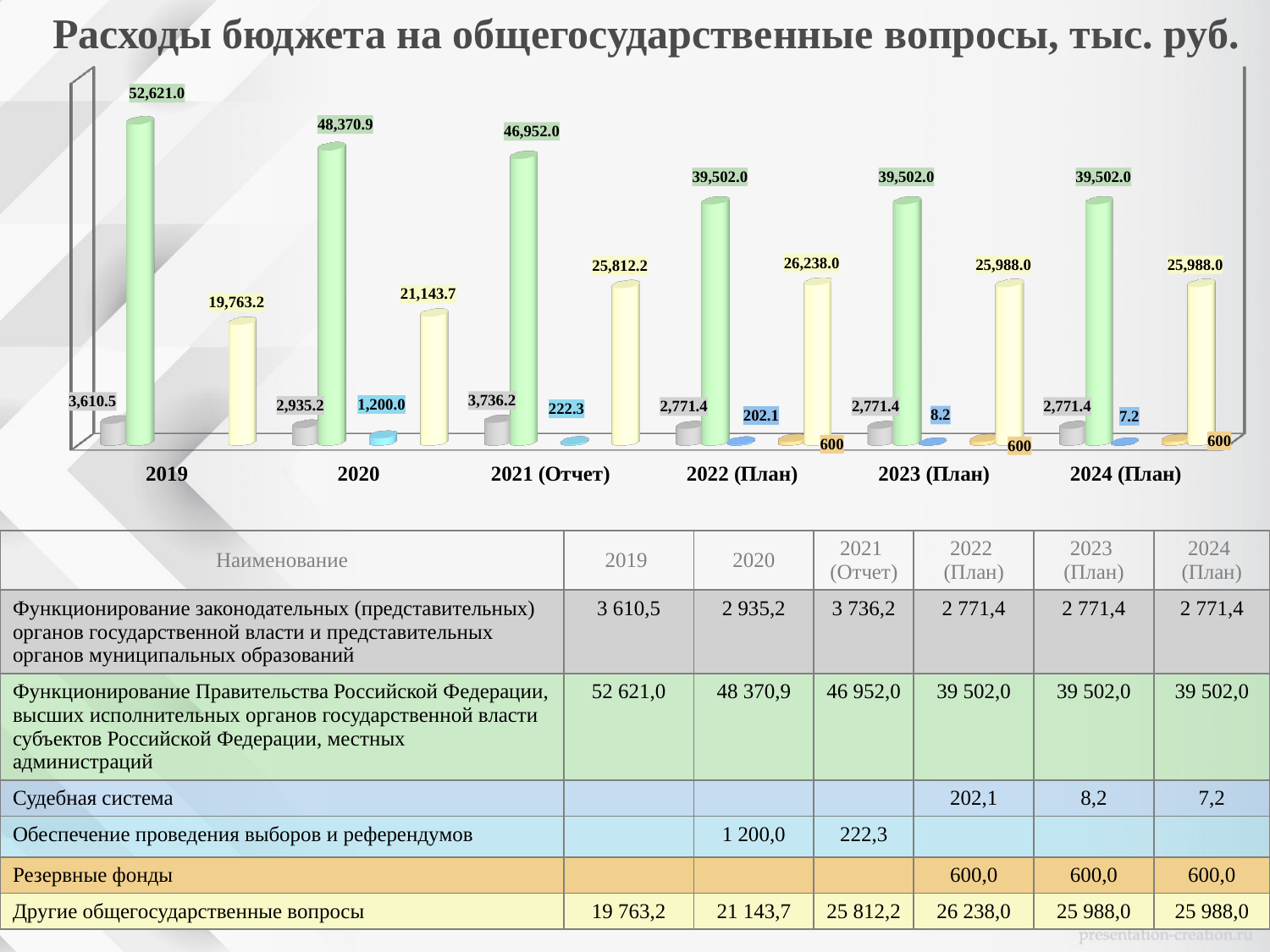
How many year categories are shown on the x axis of the chart? 6 What is the difference between the green bar values for 2019 and 2020? 4,250.1 In which year is the green bar (Функционирование Правительства Российской Федерации) the highest? 2019 What kind of chart is shown on the slide? Bar chart What is the value of the yellow bar (Другие общегосударственные вопросы) for 2022 (План)? 26,238.0 What is the value of the blue bar (Судебная система) for 2022 (План)? 202.1 What is the value of the green bar (Функционирование Правительства Российской Федерации) for 2019? 52,621.0 In which year is the yellow bar (Другие общегосударственные вопросы) the lowest? 2019 Which is larger: the yellow bar for 2021 (Отчет) or the yellow bar for 2022 (План)? 2022 (План) What is the difference between the yellow bar values for 2021 (Отчет) and 2020? 4,668.5 What is the value of the light-blue bar (Обеспечение проведения выборов и референдумов) for 2020? 1,200.0 Do the green bar values rise or fall from 2019 to 2021 (Отчет)? Fall